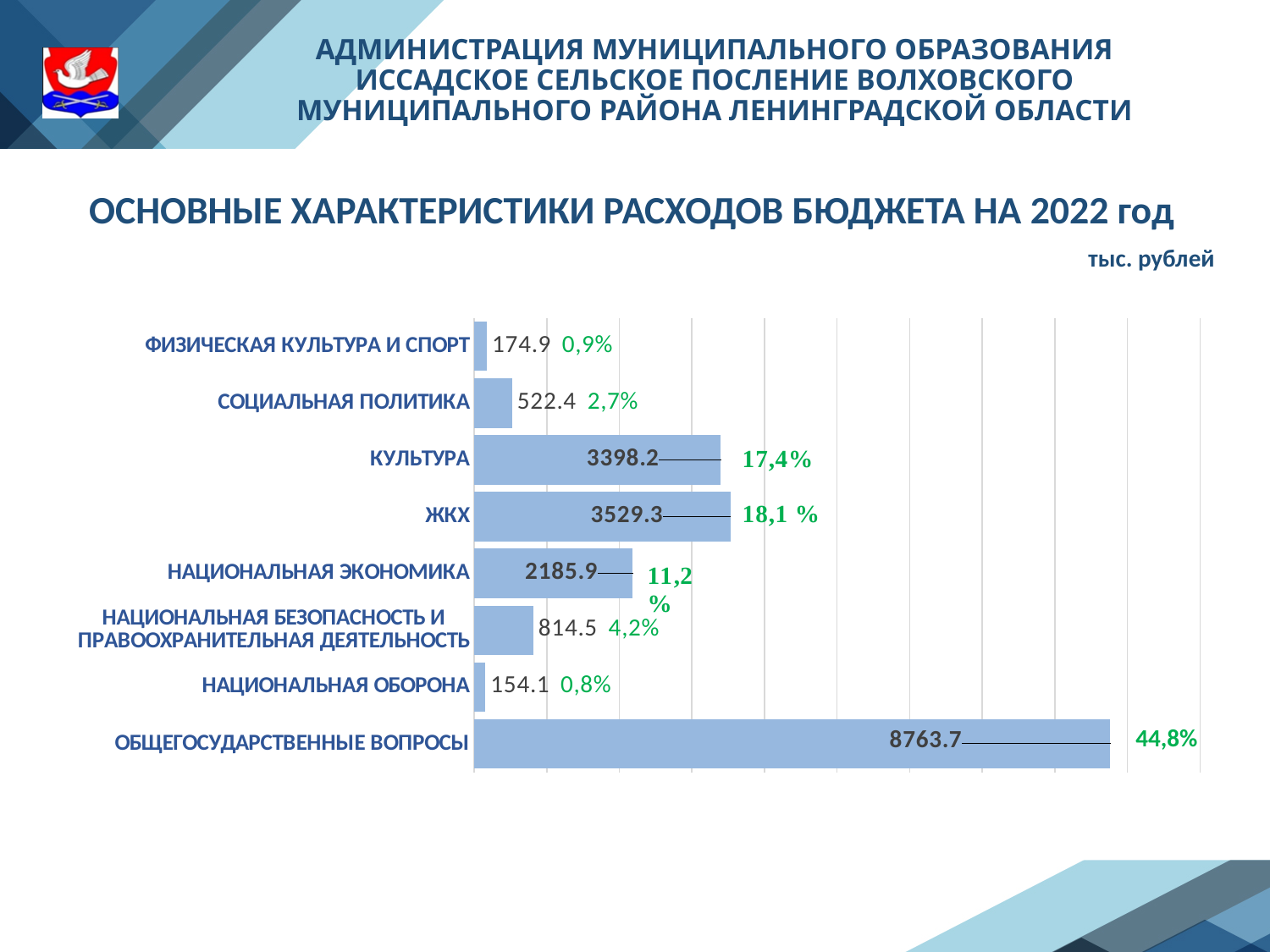
Which is larger, the value for ФИЗИЧЕСКАЯ КУЛЬТУРА И СПОРТ or the value for НАЦИОНАЛЬНАЯ ОБОРОНА? ФИЗИЧЕСКАЯ КУЛЬТУРА И СПОРТ What is the value for ОБЩЕГОСУДАРСТВЕННЫЕ ВОПРОСЫ? 8763.7 What is the difference between the values for ЖКХ and КУЛЬТУРА? 131.1 What kind of chart is shown on the slide? bar chart What unit is indicated for the values in the chart? тыс. рублей What is the difference between the values for НАЦИОНАЛЬНАЯ БЕЗОПАСНОСТЬ И ПРАВООХРАНИТЕЛЬНАЯ ДЕЯТЕЛЬНОСТЬ and СОЦИАЛЬНАЯ ПОЛИТИКА? 292.1 Which category has the highest value? ОБЩЕГОСУДАРСТВЕННЫЕ ВОПРОСЫ What percentage is shown next to the bar for КУЛЬТУРА? 17,4% What is the value for ЖКХ? 3529.3 Which category has the lowest value? НАЦИОНАЛЬНАЯ ОБОРОНА How many categories are shown in the chart? 8 What is the value for НАЦИОНАЛЬНАЯ ЭКОНОМИКА? 2185.9